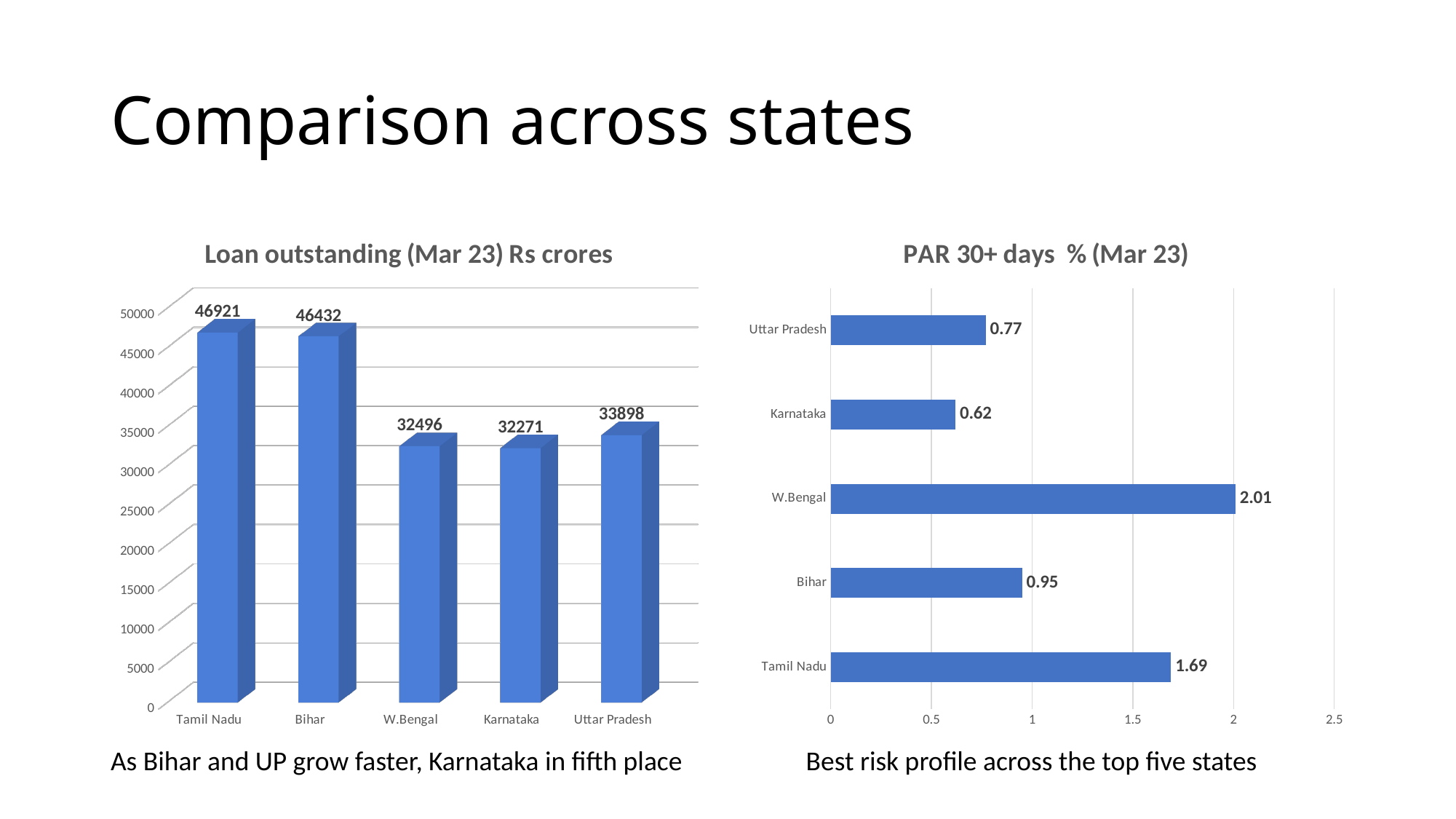
In the 'Loan outstanding (Mar 23) Rs crores' chart, what is the value for Bihar? 46432 In the 'PAR 30+ days % (Mar 23)' chart, which is larger, the value for Bihar or the value for Uttar Pradesh? Bihar In the 'PAR 30+ days % (Mar 23)' chart, what is the value for W.Bengal? 2.01 What kind of chart is the 'Loan outstanding (Mar 23) Rs crores' chart? Bar chart In the 'Loan outstanding (Mar 23) Rs crores' chart, what is the difference between Tamil Nadu and Bihar? 489 In the 'PAR 30+ days % (Mar 23)' chart, which state has the lowest PAR 30+ days %? Karnataka In the 'Loan outstanding (Mar 23) Rs crores' chart, is the value for Uttar Pradesh greater or less than 35000? less In the 'Loan outstanding (Mar 23) Rs crores' chart, which state has the highest loan outstanding? Tamil Nadu In the 'PAR 30+ days % (Mar 23)' chart, which state has the highest PAR 30+ days %? W.Bengal In the 'Loan outstanding (Mar 23) Rs crores' chart, how many states are shown? 5 In the 'Loan outstanding (Mar 23) Rs crores' chart, which state has the lowest loan outstanding? Karnataka In the 'PAR 30+ days % (Mar 23)' chart, what is the difference between W.Bengal and Tamil Nadu? 0.32